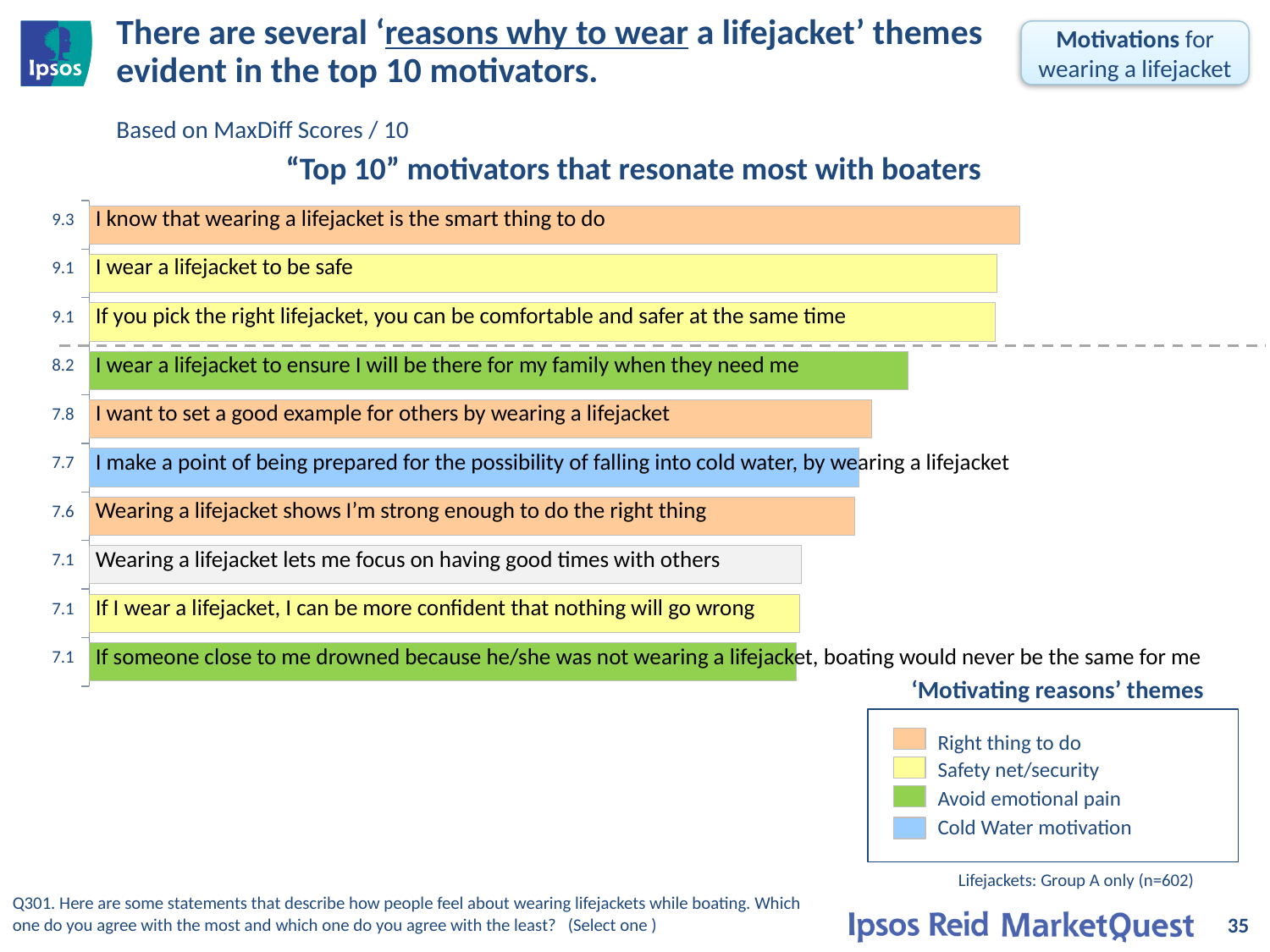
What is the difference in score between "I wear a lifejacket to be safe" and "I wear a lifejacket to ensure I will be there for my family when they need me"? 0.9 How many themes does the 'Motivating reasons' themes legend list? 4 What is the MaxDiff score for "Wearing a lifejacket shows I'm strong enough to do the right thing"? 7.6 What is the MaxDiff score for "I wear a lifejacket to ensure I will be there for my family when they need me"? 8.2 What is the MaxDiff score for "I make a point of being prepared for the possibility of falling into cold water, by wearing a lifejacket"? 7.7 What is the MaxDiff score for "I know that wearing a lifejacket is the smart thing to do"? 9.3 What is the difference between the highest score (9.3) and the score for "I want to set a good example for others by wearing a lifejacket"? 1.5 Which theme in the legend is shown in green? Avoid emotional pain Which has a higher score: "I want to set a good example for others by wearing a lifejacket" or "Wearing a lifejacket lets me focus on having good times with others"? I want to set a good example for others by wearing a lifejacket Which motivator has the highest MaxDiff score? I know that wearing a lifejacket is the smart thing to do What type of chart is used to show the top 10 motivators? Bar chart How many motivators are shown in the chart? 10